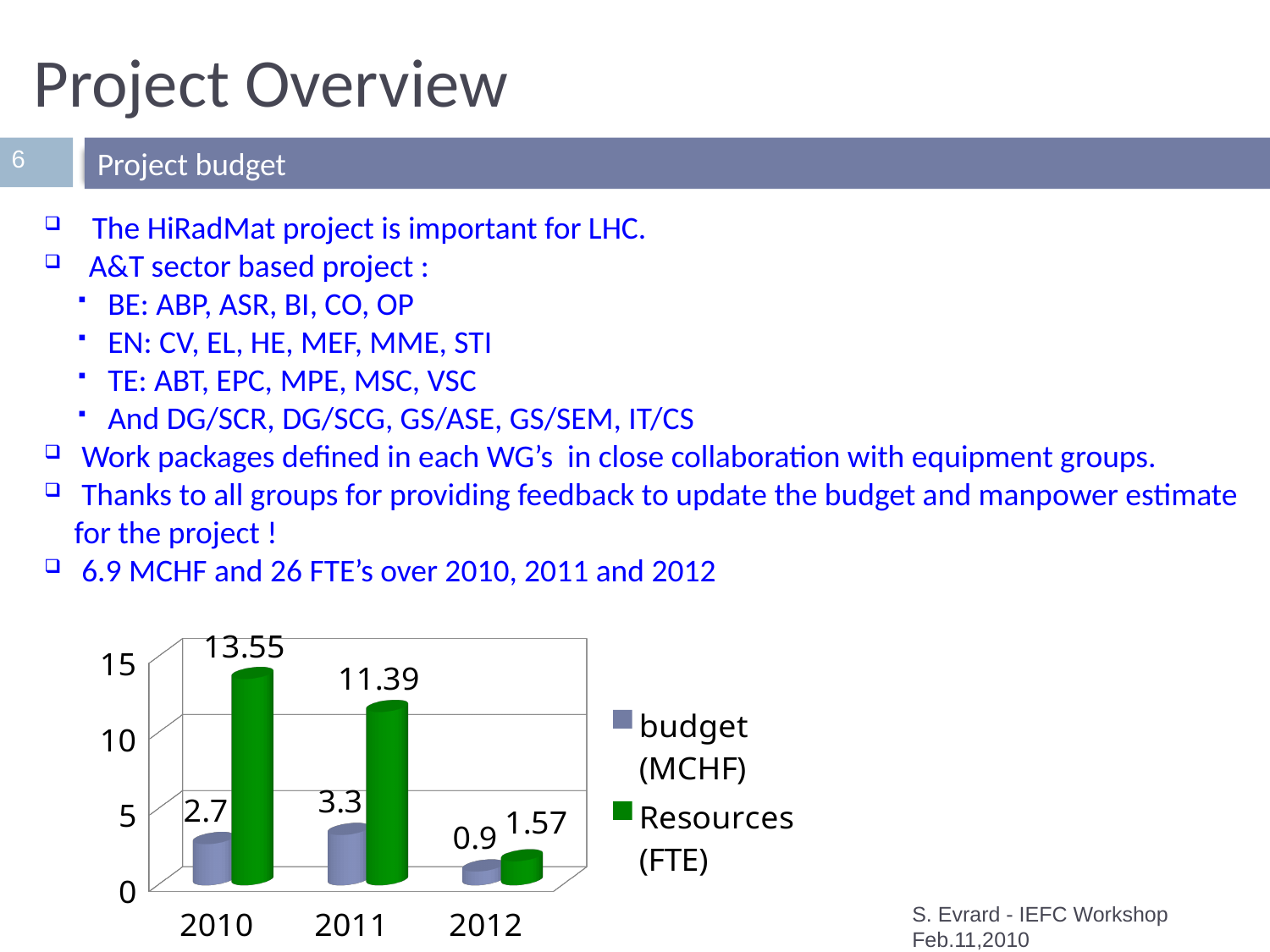
What is the budget (MCHF) value for 2010? 2.7 How many years are shown on the x axis of the chart? 3 Which year has the highest Resources (FTE) value? 2010 What is the difference between the Resources (FTE) values for 2010 and 2011? 2.16 Which is larger, the budget (MCHF) for 2011 or the budget (MCHF) for 2010? 2011 Do the Resources (FTE) values rise or fall from 2010 to 2012? fall What is the budget (MCHF) value for 2012? 0.9 What is the Resources (FTE) value for 2011? 11.39 Is the Resources (FTE) value for 2011 greater or less than 10? greater Which year has the lowest budget (MCHF) value? 2012 How many series does the chart legend list? 2 What kind of chart is shown on the slide? bar chart